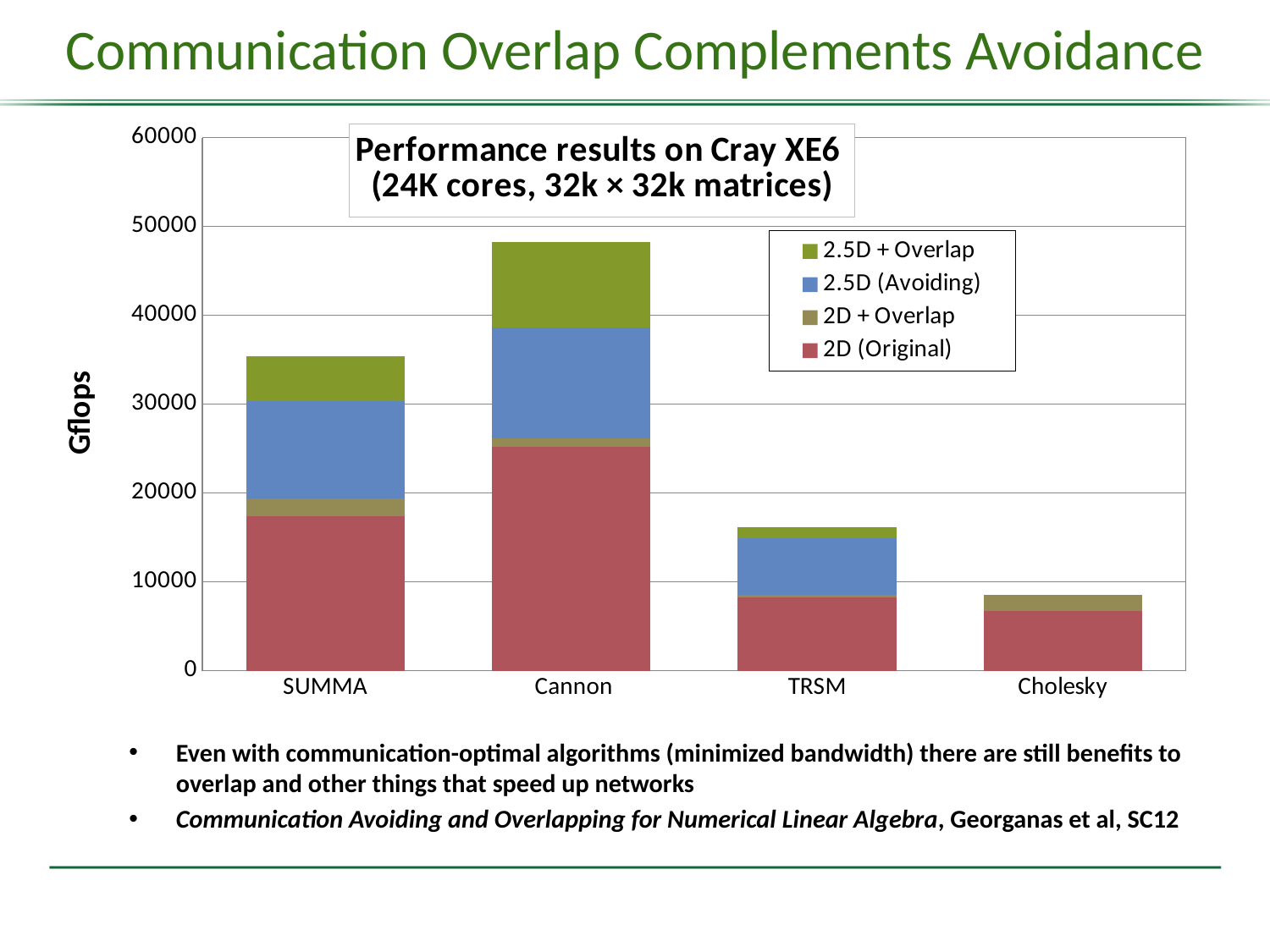
What is the label on the y axis? Gflops Is the total height of the TRSM bar greater or less than 20000? less Which algorithm has the shortest stacked bar? Cholesky How many series does the legend list? 4 Is the total height of the Cholesky bar greater or less than 10000? less What is the title of the chart? Performance results on Cray XE6 (24K cores, 32k × 32k matrices) Which stacked bar is taller, SUMMA or TRSM? SUMMA Is the 2D (Original) value for Cannon greater or less than 20000? greater How many algorithms (categories) are shown on the x axis? 4 What kind of chart is shown on the slide? Stacked bar chart Which algorithm has the tallest stacked bar? Cannon